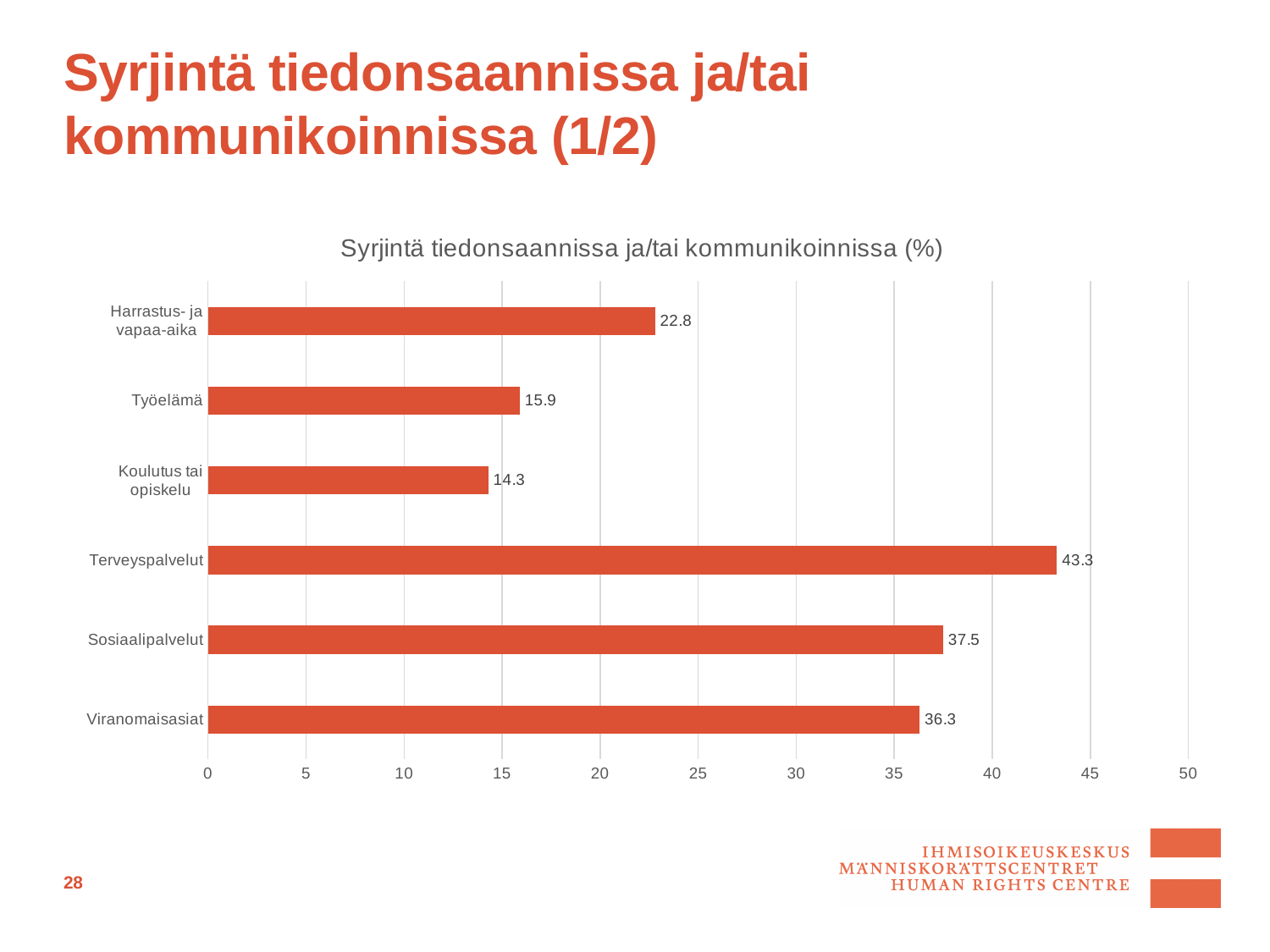
What kind of chart is shown on the slide? bar chart What is the difference between the values for Terveyspalvelut and Sosiaalipalvelut? 5.8 Which category has the highest value? Terveyspalvelut Which category has the lowest value? Koulutus tai opiskelu Is the value for Harrastus- ja vapaa-aika greater or less than 25? less What is the value for Työelämä? 15.9 What is the value for Terveyspalvelut? 43.3 What is the difference between the values for Harrastus- ja vapaa-aika and Koulutus tai opiskelu? 8.5 What is the title of the chart? Syrjintä tiedonsaannissa ja/tai kommunikoinnissa (%) What is the value for Viranomaisasiat? 36.3 How many categories are shown in the chart? 6 Which is larger, the value for Sosiaalipalvelut or the value for Viranomaisasiat? Sosiaalipalvelut